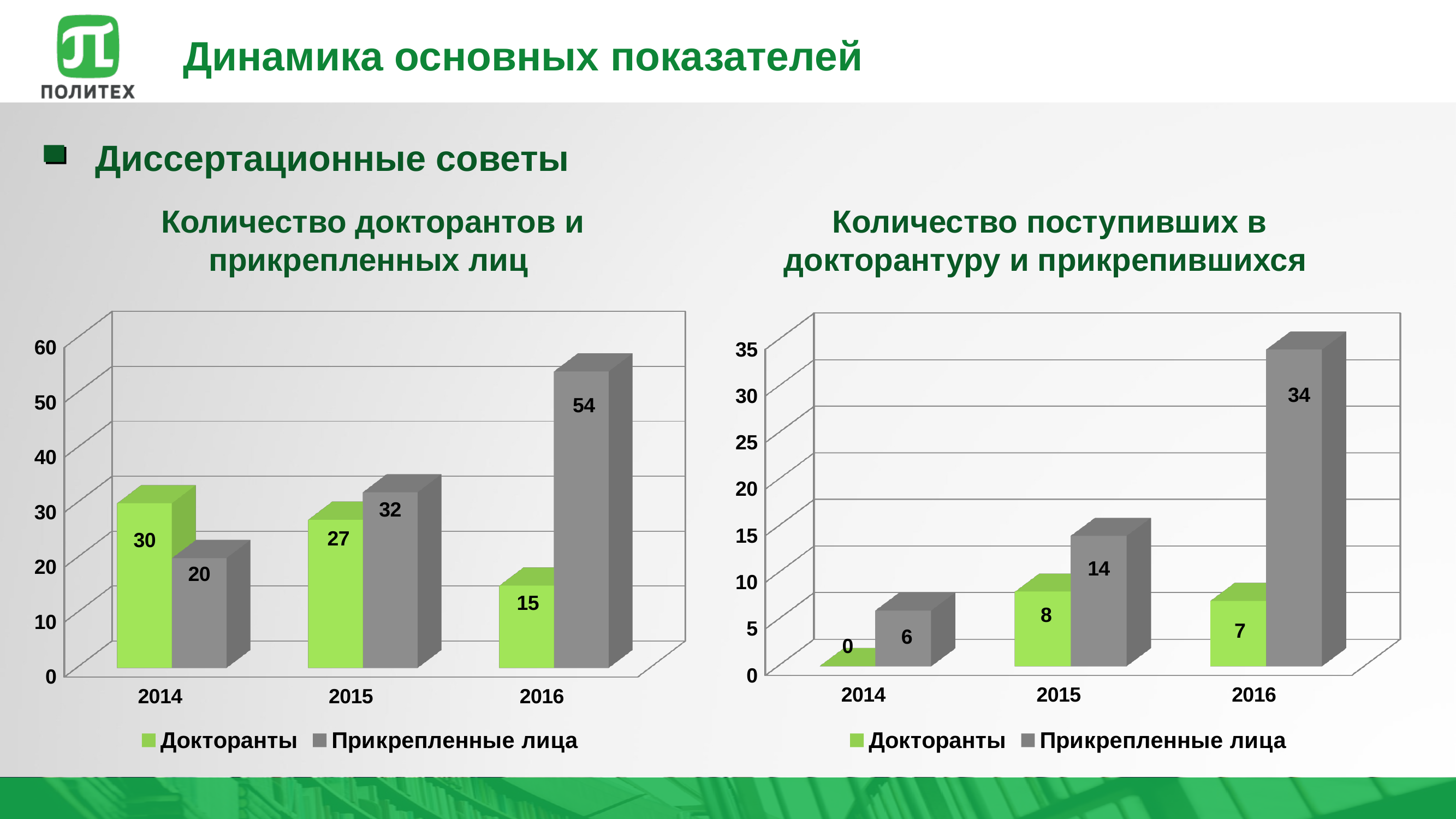
What kind of chart is 'Количество поступивших в докторантуру и прикрепившихся'? bar chart In the chart 'Количество поступивших в докторантуру и прикрепившихся', do the values for Прикрепленные лица rise or fall from 2014 to 2016? rise In the chart 'Количество поступивших в докторантуру и прикрепившихся', what is the difference between Прикрепленные лица in 2016 and 2015? 20 In the chart 'Количество докторантов и прикрепленных лиц', which year has the highest value for Прикрепленные лица? 2016 How many series does the legend of the chart 'Количество докторантов и прикрепленных лиц' list? 2 In the chart 'Количество докторантов и прикрепленных лиц', what is the value for Докторанты in 2014? 30 In the chart 'Количество докторантов и прикрепленных лиц', what is the difference between Прикрепленные лица and Докторанты in 2016? 39 In the chart 'Количество докторантов и прикрепленных лиц', what is the value for Прикрепленные лица in 2016? 54 In the chart 'Количество докторантов и прикрепленных лиц', which is larger in 2014: Докторанты or Прикрепленные лица? Докторанты In the chart 'Количество поступивших в докторантуру и прикрепившихся', what is the value for Прикрепленные лица in 2015? 14 In the chart 'Количество докторантов и прикрепленных лиц', which year has the lowest value for Докторанты? 2016 In the chart 'Количество поступивших в докторантуру и прикрепившихся', what is the value for Докторанты in 2014? 0